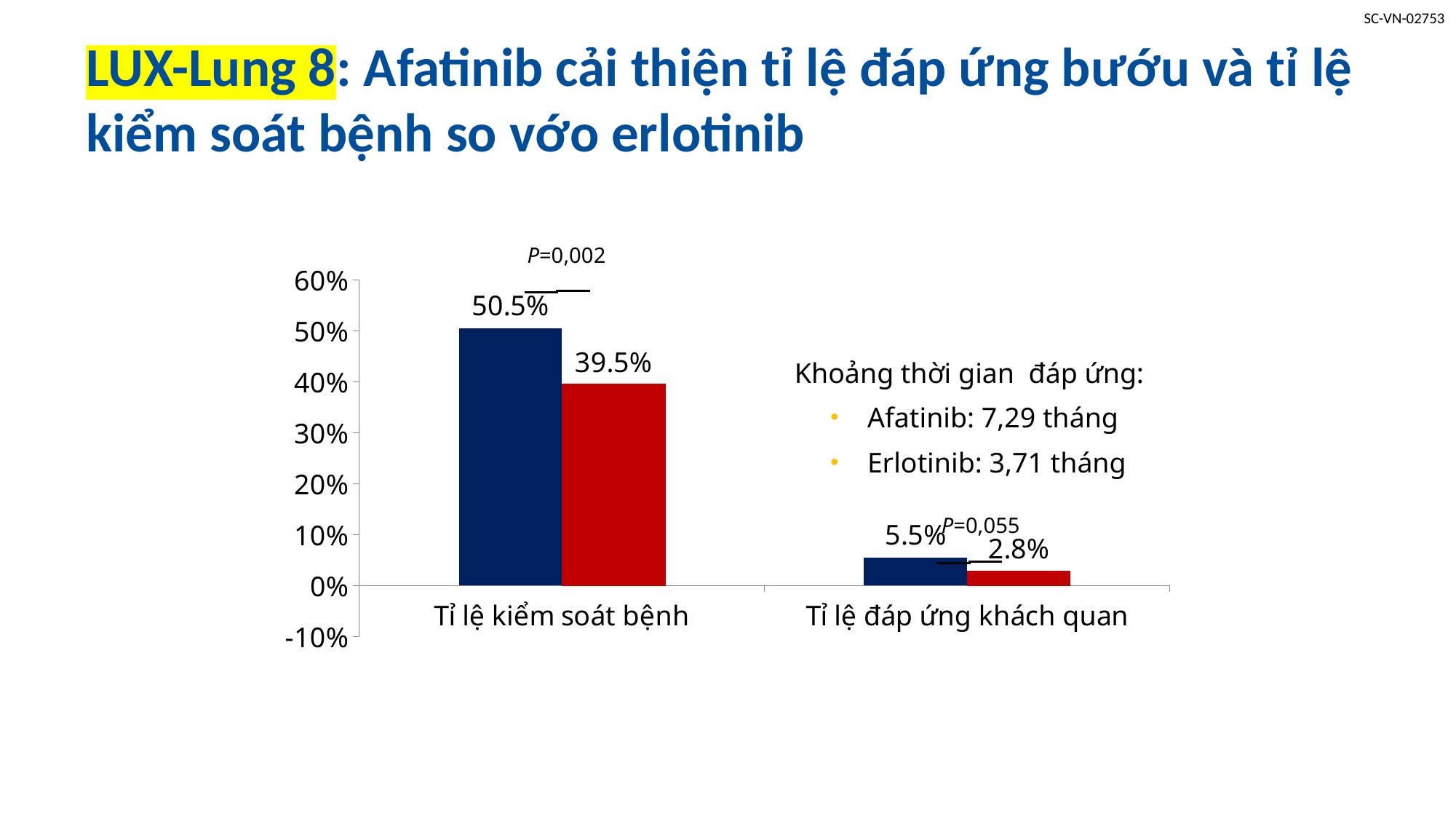
What P value is printed above the bars for "Tỉ lệ kiểm soát bệnh"? P=0,002 Which bar in the chart has the lowest value? the red bar for Tỉ lệ đáp ứng khách quan (2.8%) Which bar in the chart has the highest value? the dark blue bar for Tỉ lệ kiểm soát bệnh (50.5%) Which bar is taller for "Tỉ lệ kiểm soát bệnh", the dark blue bar or the red bar? the dark blue bar What is the value of the red bar for "Tỉ lệ đáp ứng khách quan"? 2.8% What is the value of the dark blue bar for "Tỉ lệ kiểm soát bệnh"? 50.5% What is the value of the dark blue bar for "Tỉ lệ đáp ứng khách quan"? 5.5% What is the difference between the dark blue and red bars for "Tỉ lệ kiểm soát bệnh"? 11.0% What is the difference between the dark blue and red bars for "Tỉ lệ đáp ứng khách quan"? 2.7% What kind of chart is shown on the slide? bar chart What is the value of the red bar for "Tỉ lệ kiểm soát bệnh"? 39.5% How many categories are shown on the x axis of the chart? 2